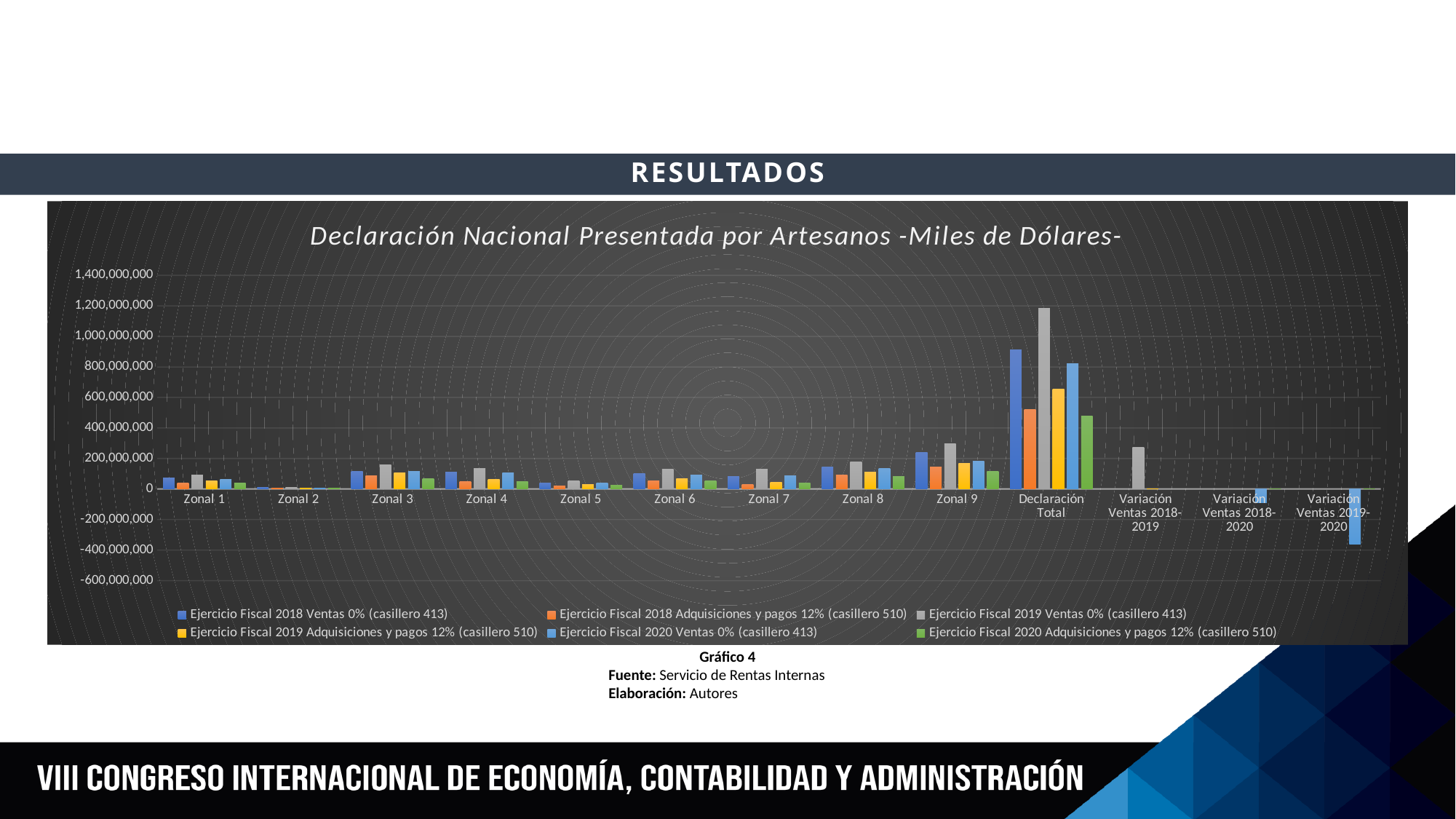
Which series has the highest bar in the Declaración Total category? Ejercicio Fiscal 2019 Ventas 0% (casillero 413) How many categories are shown along the x axis of the chart? 13 Which category has the tallest bar in the chart? Declaración Total Is the value of Ejercicio Fiscal 2019 Ventas 0% (casillero 413) for Variación Ventas 2018-2019 greater or less than 200,000,000? greater For Declaración Total, which is larger: Ejercicio Fiscal 2018 Ventas 0% (casillero 413) or Ejercicio Fiscal 2018 Adquisiciones y pagos 12% (casillero 510)? Ejercicio Fiscal 2018 Ventas 0% (casillero 413) Is the value of Ejercicio Fiscal 2019 Ventas 0% (casillero 413) for Declaración Total greater or less than 1,000,000,000? greater How many series does the chart legend list? 6 Which category has the lowest (most negative) bar in the chart? Variación Ventas 2019-2020 Among Zonal 1 through Zonal 9, which zone has the tallest bar? Zonal 9 What kind of chart is shown on the slide? bar chart Is the value of Ejercicio Fiscal 2020 Ventas 0% (casillero 413) for Variación Ventas 2019-2020 greater or less than -200,000,000? less What is the title of the chart? Declaración Nacional Presentada por Artesanos -Miles de Dólares-